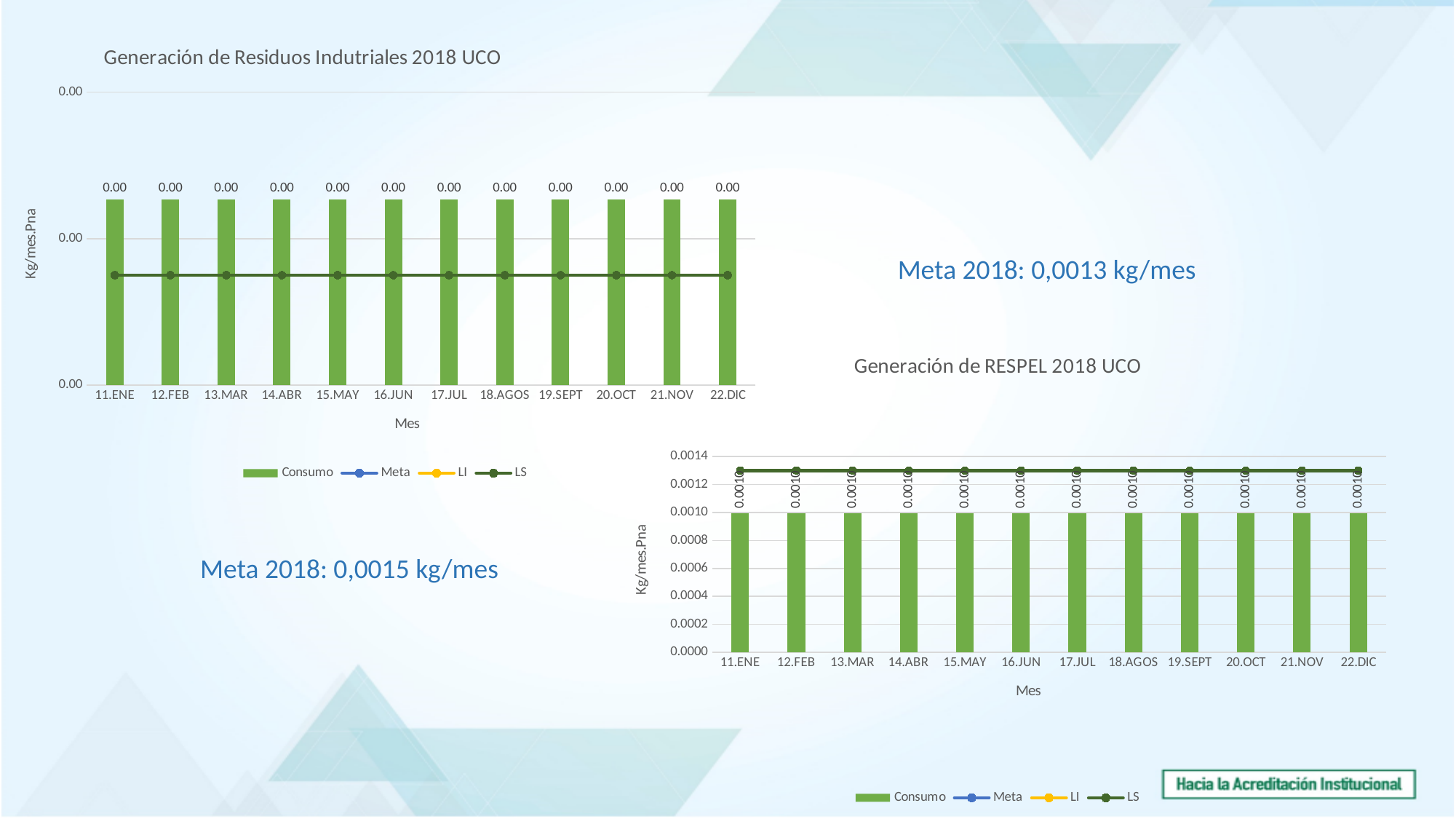
How many series does the legend of the chart titled 'Generación de Residuos Indutriales 2018 UCO' list? 4 In the chart titled 'Generación de RESPEL 2018 UCO', which is larger for 13.MAR: the LS line or the Consumo bar? LS In the chart titled 'Generación de RESPEL 2018 UCO', is the Consumo value for 16.JUN greater or less than 0.0012? less In the chart titled 'Generación de RESPEL 2018 UCO', is the LS line greater or less than 0.0012? greater How many months (categories) are plotted on the x axis of the chart titled 'Generación de RESPEL 2018 UCO'? 12 In the chart titled 'Generación de Residuos Indutriales 2018 UCO', what is the data label shown above the bar for 15.MAY? 0.00 What kind of chart is used for the Consumo series in the chart titled 'Generación de RESPEL 2018 UCO'? Bar chart In the chart titled 'Generación de RESPEL 2018 UCO', what is the data label on the Consumo bar for 11.ENE? 0.0010 In the chart titled 'Generación de RESPEL 2018 UCO', do the Consumo values rise, fall, or stay flat from 11.ENE to 22.DIC? Stay flat In the chart titled 'Generación de RESPEL 2018 UCO', what is the data label on the Consumo bar for 22.DIC? 0.0010 What are the four legend entries of the chart titled 'Generación de RESPEL 2018 UCO'? Consumo, Meta, LI, LS What is the y-axis title of the chart titled 'Generación de RESPEL 2018 UCO'? Kg/mes.Pna